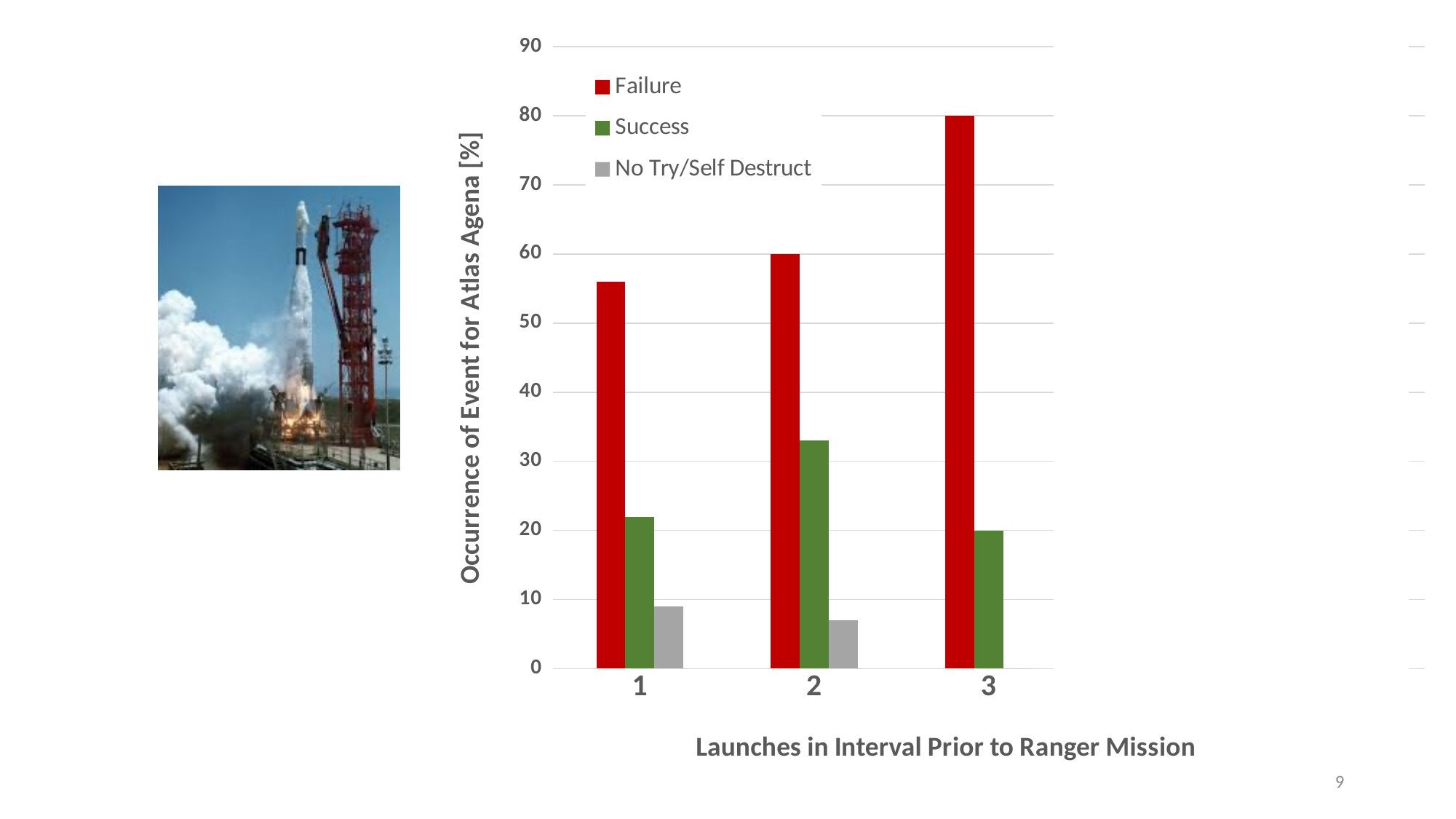
Is the Success value for interval 2 greater or less than 30? greater Is the No Try/Self Destruct value for interval 1 greater or less than 10? less Is the Failure value for interval 1 greater or less than 50? greater How many series does the legend list? 3 What is the label of the y axis? Occurrence of Event for Atlas Agena [%] Do the Failure values rise or fall as the launch interval goes from 1 to 3? rise What kind of chart is shown on the slide? bar chart For which launch interval is the Success value highest? 2 Which is larger for interval 3, the Failure value or the Success value? Failure How many categories are shown on the x axis? 3 Which series is shown in red in the legend? Failure For which launch interval is the Failure value highest? 3